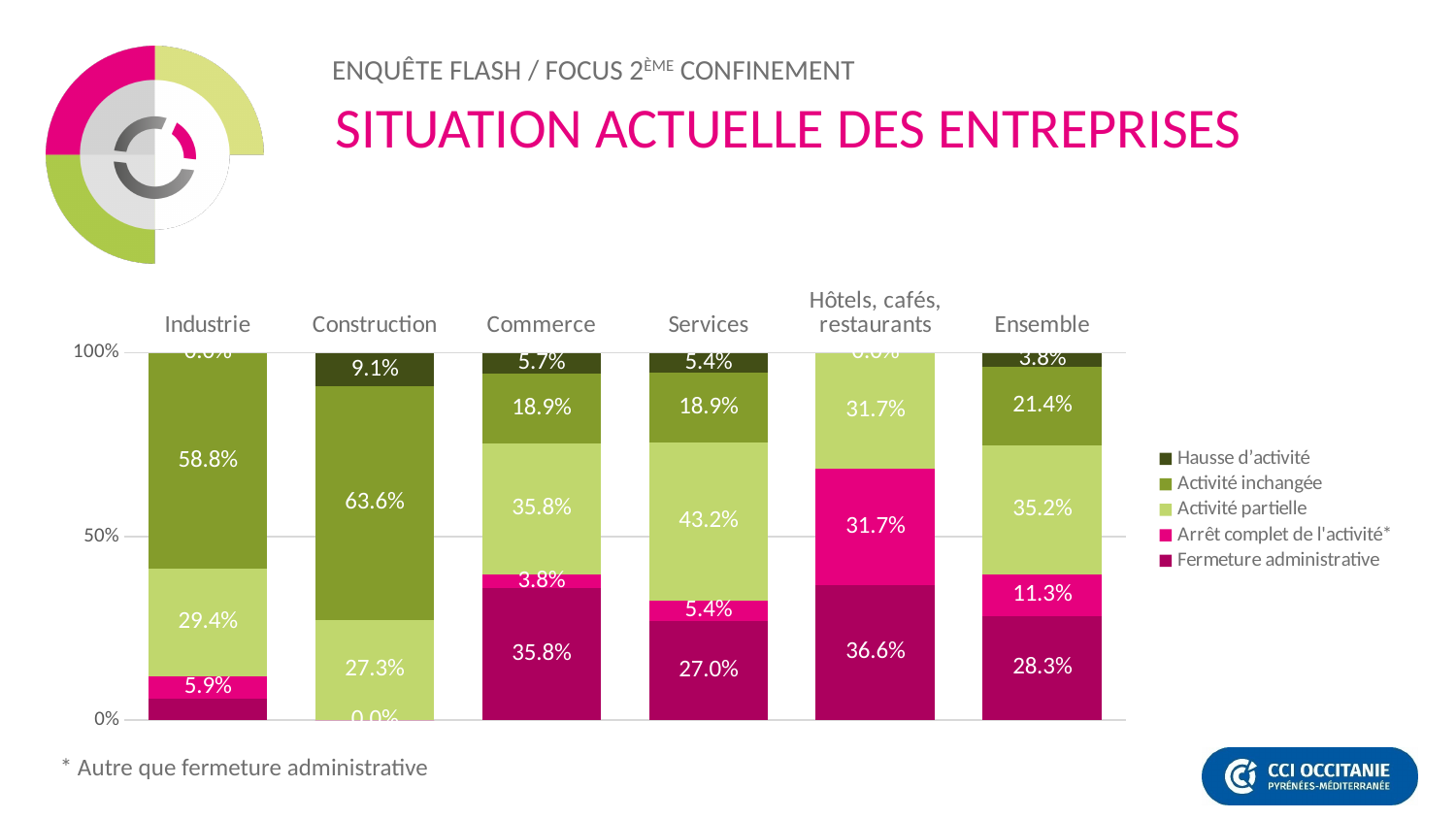
What is the value of Hausse d'activité for Ensemble? 3.8% What is the title of the chart on the slide? SITUATION ACTUELLE DES ENTREPRISES What is the value of Fermeture administrative for Hôtels, cafés, restaurants? 36.6% What is the difference between the Fermeture administrative values for Commerce and Services? 8.8% Which category has the highest value for Fermeture administrative? Hôtels, cafés, restaurants How many series does the legend list? 5 What is the value of Activité inchangée for Construction? 63.6% Which is larger: Activité partielle for Industrie or Activité partielle for Ensemble? Ensemble What kind of chart is shown on the slide? Stacked bar chart Which category has the highest value for Activité inchangée? Construction What is the value of Activité partielle for Services? 43.2% How many categories are shown along the x axis? 6